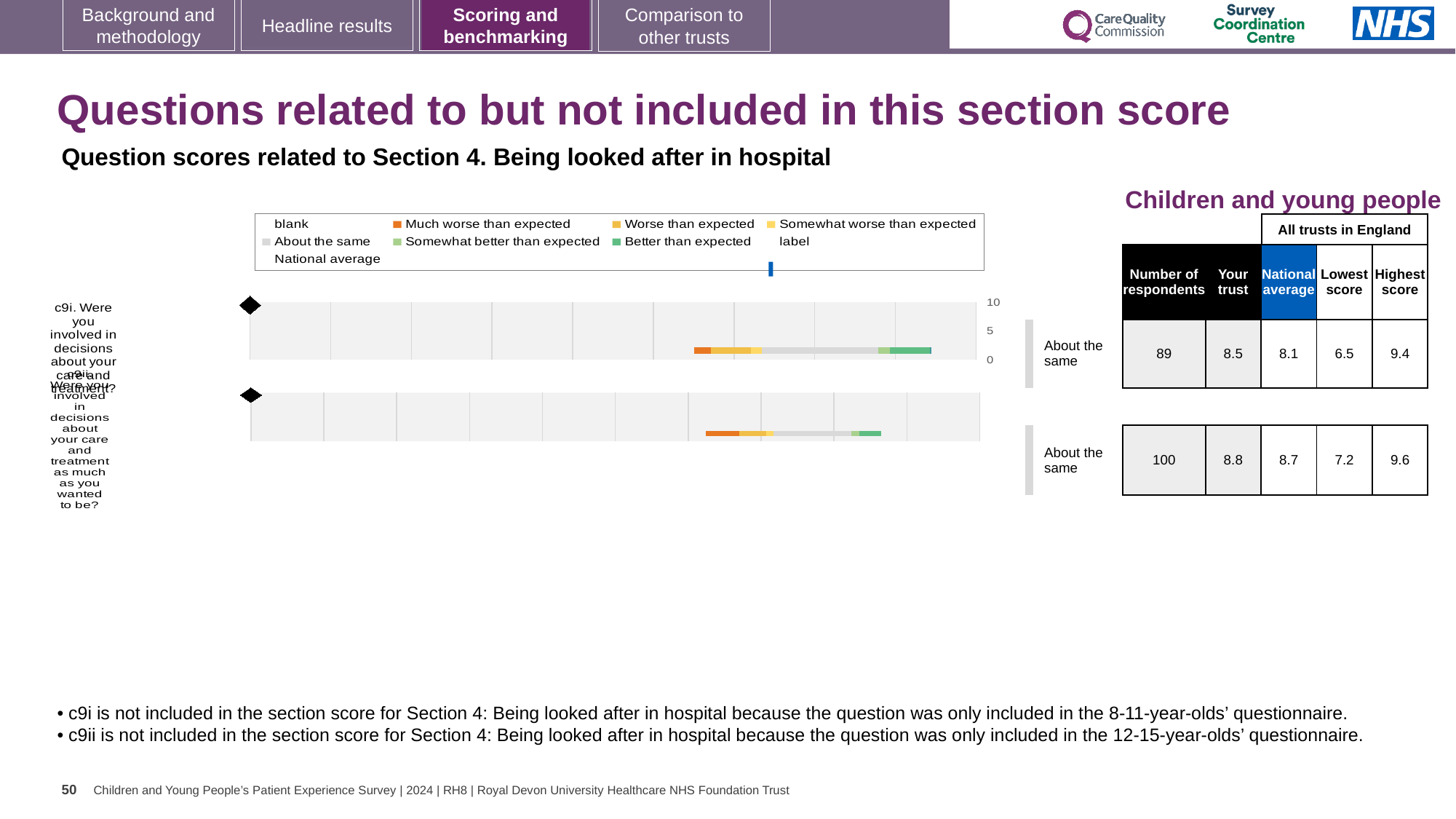
Which question has the larger 'Your trust' score, c9i or c9ii? c9ii What benchmark category is shown beside the bar for c9ii? About the same What kind of chart is used to show the question scores for c9i and c9ii? bar chart What is the highest value shown on the chart's axis? 10 What is the difference between the 'Your trust' scores for c9ii and c9i? 0.3 In the table next to the chart, what is the 'Your trust' score for c9ii? 8.8 How many questions (bars) are plotted in the chart area? 2 How many respondents answered c9ii according to the table next to the chart? 100 What benchmark category is shown beside the bar for c9i? About the same In the table next to the chart, what is the national average for c9i? 8.1 In the table next to the chart, what is the 'Your trust' score for c9i? 8.5 In the table next to the chart, what is the highest score for c9ii? 9.6